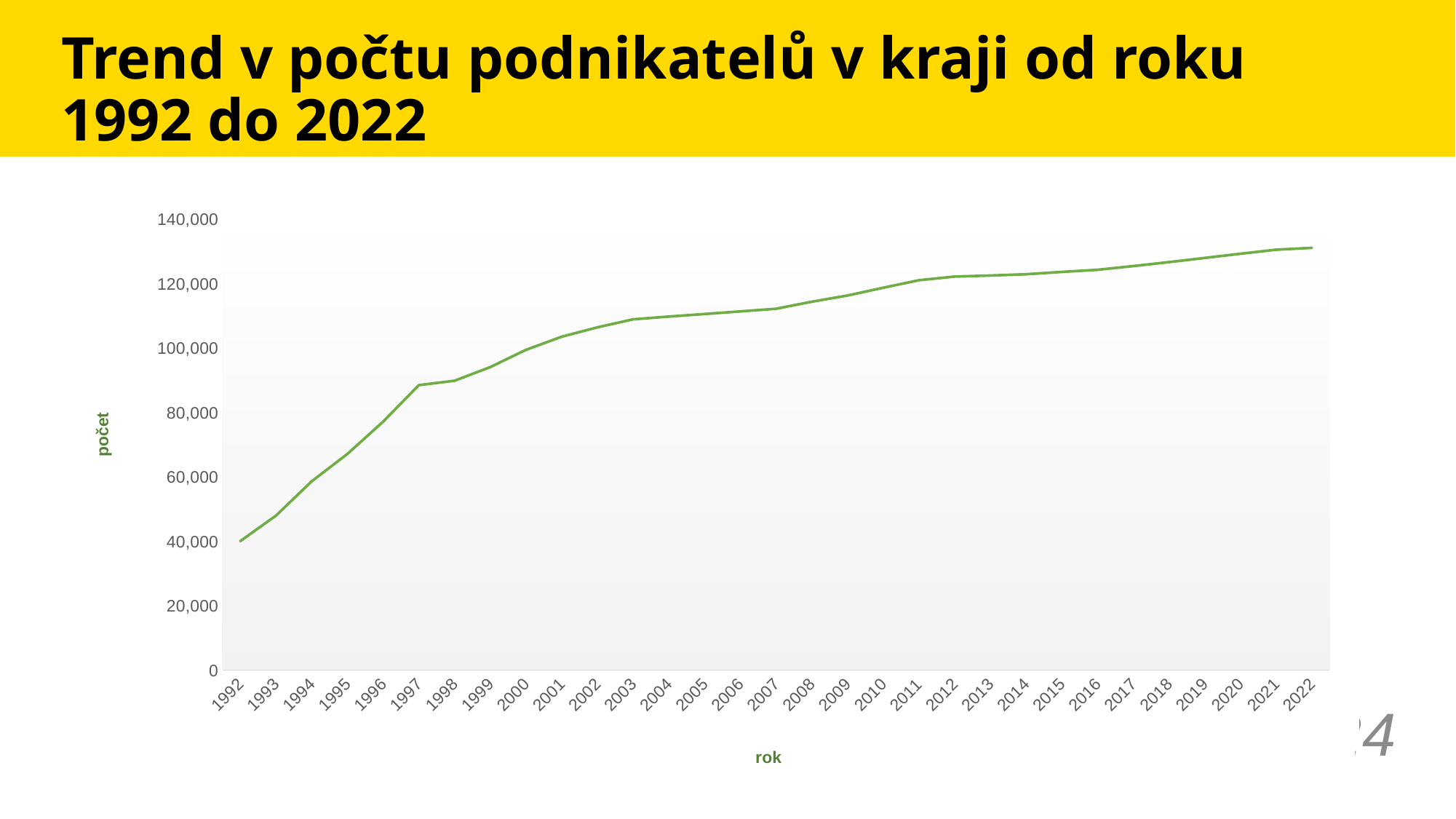
Do the values rise or fall from 1992 to 2022? rise Is the value for 1997 greater or less than 80,000? greater Is the value for 2022 greater or less than 120,000? greater Which year has the highest value? 2022 Is the value for 2003 greater or less than 100,000? greater What is the title of the chart on the slide? Trend v počtu podnikatelů v kraji od roku 1992 do 2022 Which year has the lowest value? 1992 Which year has the larger value, 1995 or 2005? 2005 How many years are plotted along the x axis? 31 What is the label of the vertical axis? počet What kind of chart is shown on the slide? line chart